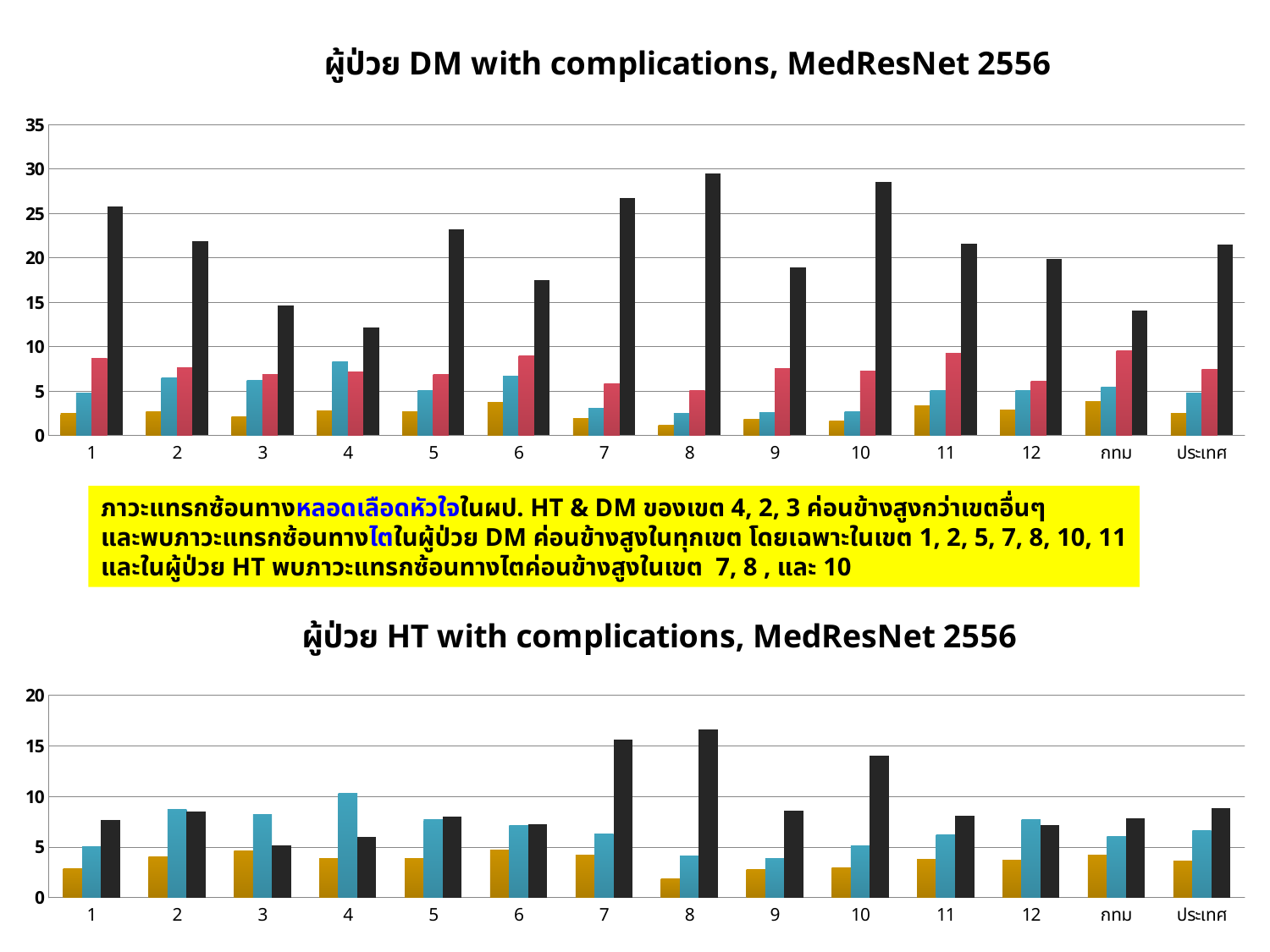
In the bottom chart, 'ผู้ป่วย HT with complications', which category has the highest black bar? 8 In the top chart, 'ผู้ป่วย DM with complications', which category has the lowest black bar? 4 In the top chart, 'ผู้ป่วย DM with complications', is the black bar for category 4 greater or less than 10? greater What kind of chart is the top chart, 'ผู้ป่วย DM with complications, MedResNet 2556'? bar chart How many categories are shown on the x axis of the top chart, 'ผู้ป่วย DM with complications, MedResNet 2556'? 14 What is the highest value shown on the y axis of the bottom chart, 'ผู้ป่วย HT with complications, MedResNet 2556'? 20 In the top chart, 'ผู้ป่วย DM with complications', is the black bar for category 1 larger or smaller than the black bar for category 2? larger In the bottom chart, 'ผู้ป่วย HT with complications', for category 4, is the blue bar larger or smaller than the black bar? larger What kind of chart is the bottom chart, 'ผู้ป่วย HT with complications, MedResNet 2556'? bar chart In the bottom chart, 'ผู้ป่วย HT with complications', is the black bar for category 8 greater or less than 15? greater In the top chart, 'ผู้ป่วย DM with complications', is the red bar for กทม greater or less than 5? greater